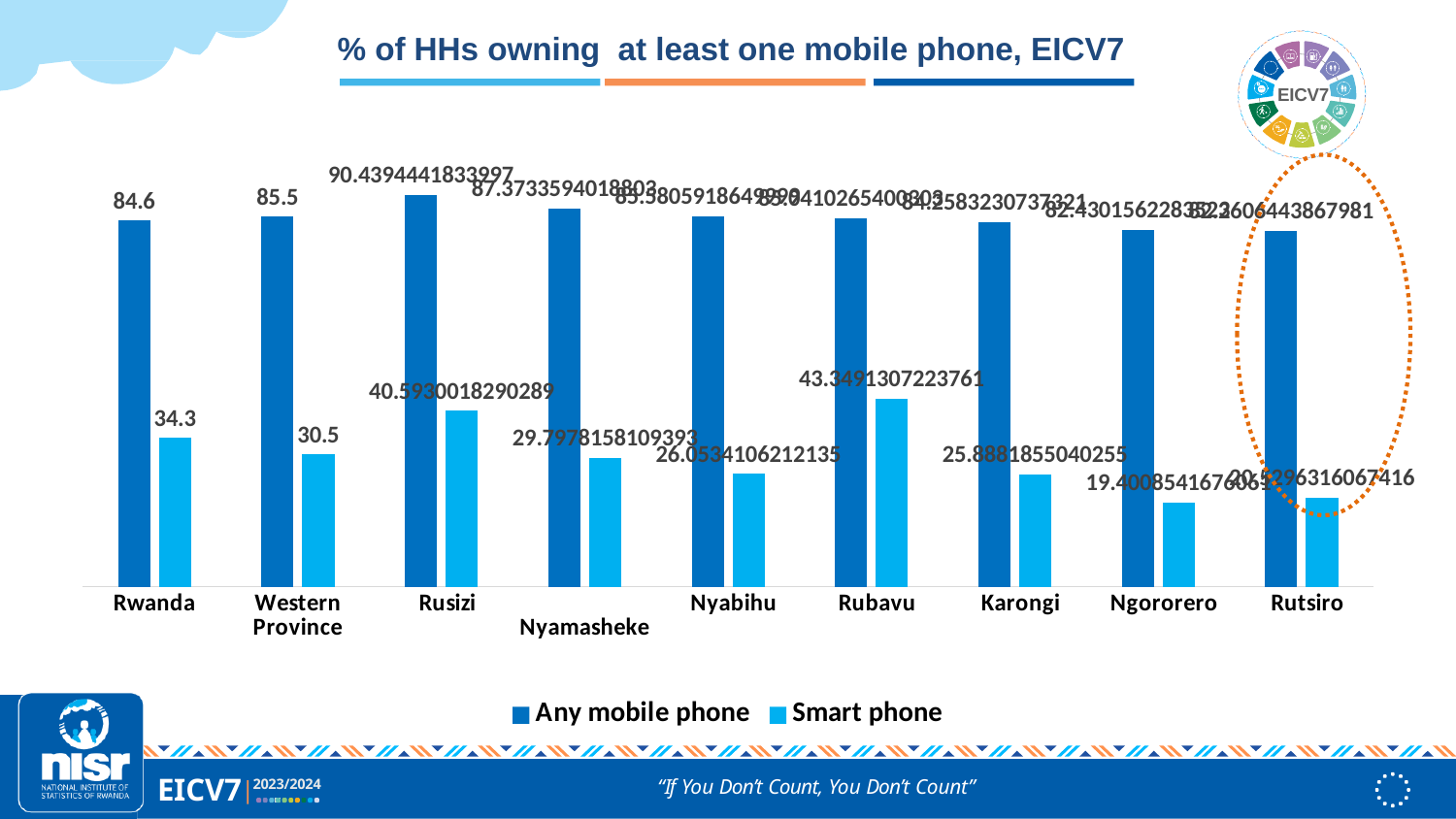
What is the Smart phone value shown for Rubavu? 43.3491307223761 How many series does the legend list? 2 What is the Smart phone value shown for Karongi? 25.8881855040255 What percentage of households in Rwanda own any mobile phone? 84.6 What is the Smart phone value for Western Province? 30.5 How many categories are shown on the x axis? 9 What kind of chart is shown on the slide? Bar chart What is the title of the chart? % of HHs owning at least one mobile phone, EICV7 What is the difference between the Any mobile phone and Smart phone values for Rwanda? 50.3 Which district has the highest value for Any mobile phone? Rusizi Which category has the highest Smart phone value? Rubavu Which has a higher Any mobile phone value, Rwanda or Western Province? Western Province